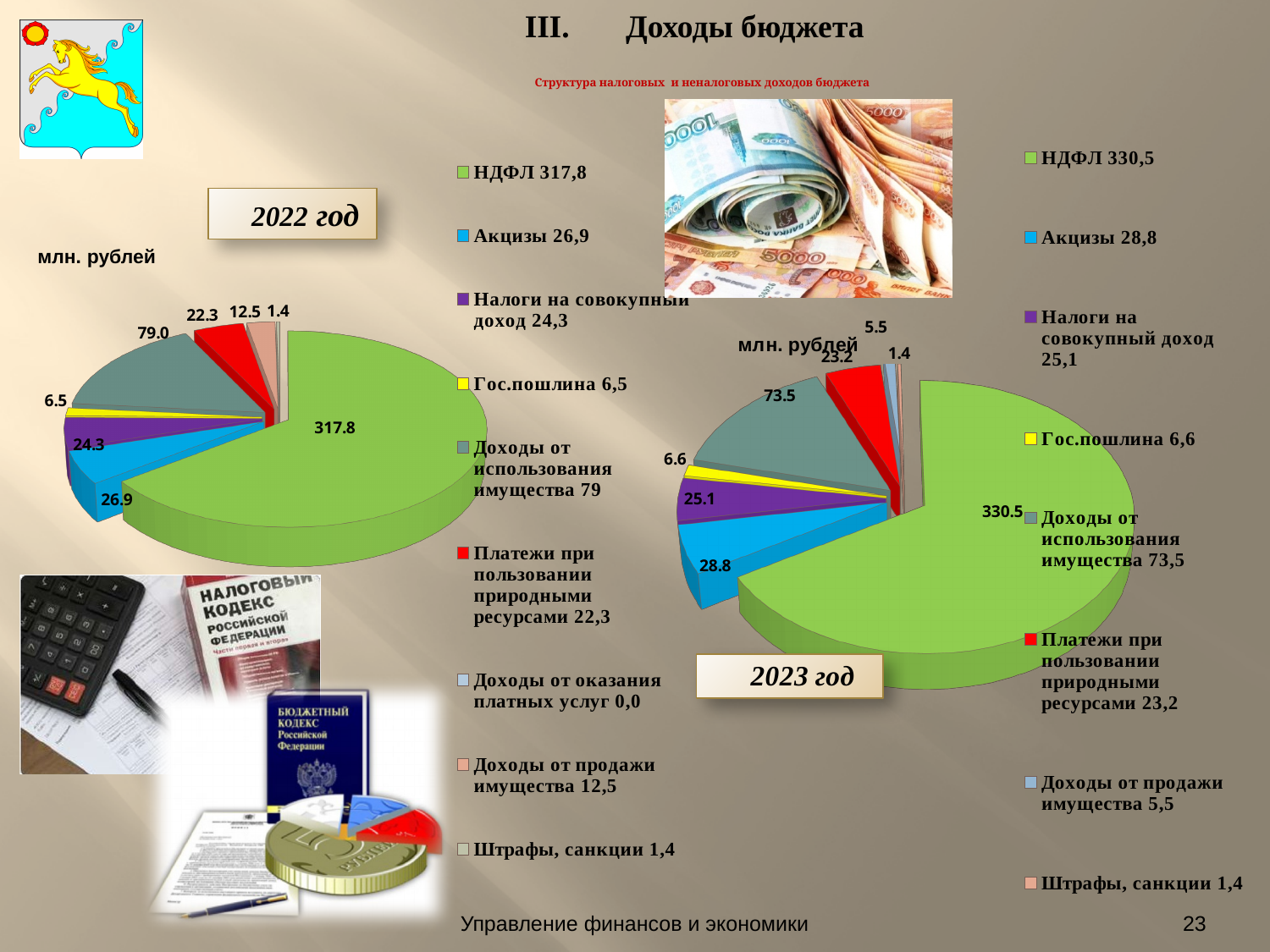
On the 2022 год chart, what is the value for Доходы от использования имущества? 79.0 On the 2023 год chart, what is the difference between НДФЛ and Доходы от использования имущества? 257.0 What unit is shown next to the 2023 год chart? млн. рублей On the 2023 год chart, what is the value for Доходы от продажи имущества? 5.5 On the 2022 год chart, which is larger: Акцизы or Налоги на совокупный доход? Акцизы On the 2022 год chart, which category has the largest slice? НДФЛ On the 2023 год chart, what is the value for Акцизы? 28.8 On the 2023 год chart, which category has the smallest value? Штрафы, санкции How many categories does the legend of the 2022 год chart list? 9 On the 2022 год chart, what is the value for НДФЛ? 317.8 How many categories does the legend of the 2023 год chart list? 8 What type of chart is the 2022 год chart? Pie chart